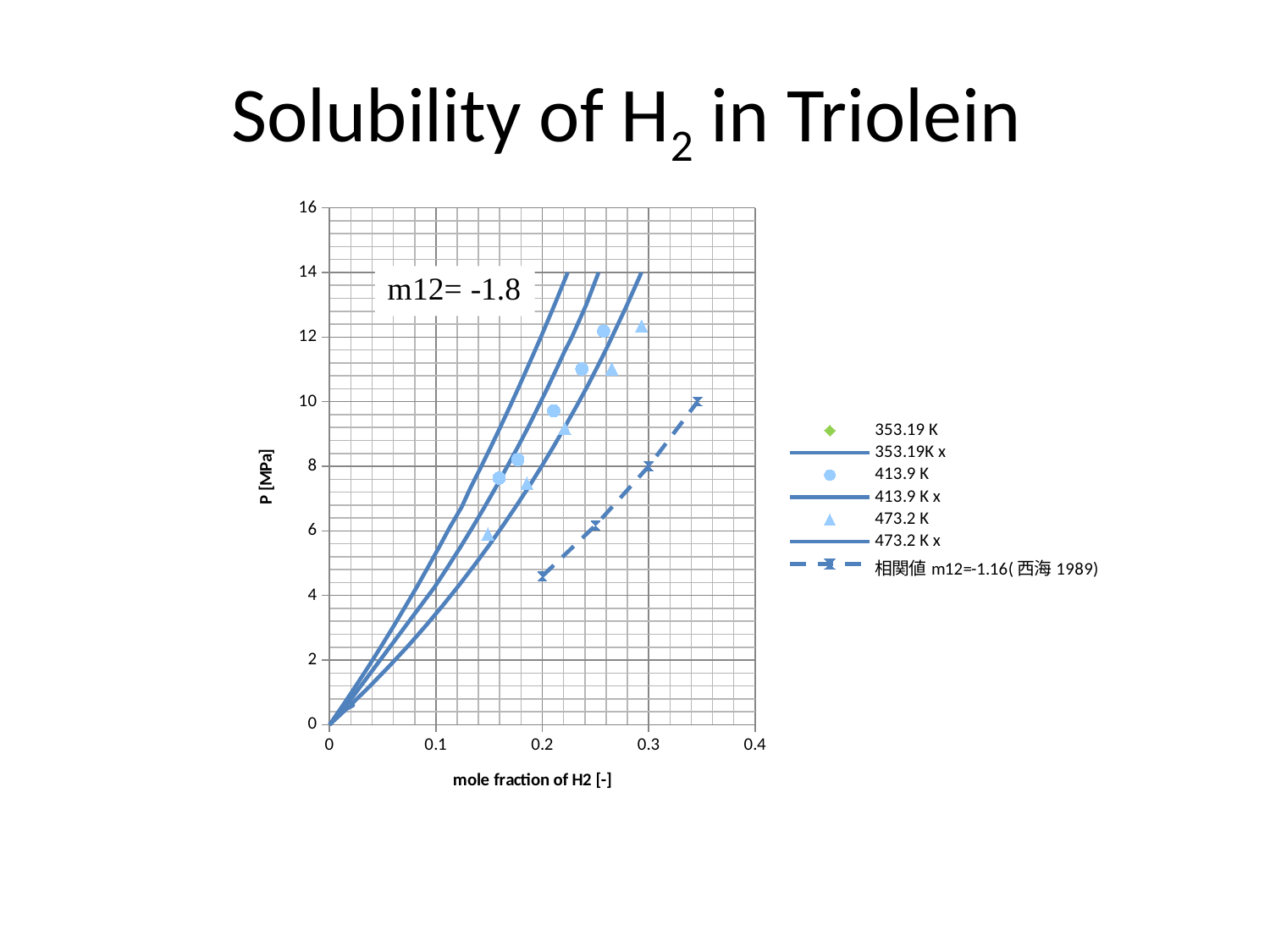
What is the label of the x axis? mole fraction of H2 [-] Is the pressure of the highest point on the dashed correlation line (相関値 m12=-1.16) greater or less than 8 MPa? greater Is the pressure of the highest 413.9 K data point greater or less than 10 MPa? greater At a mole fraction of about 0.3, which is higher: the 473.2 K data point or the dashed correlation line? 473.2 K data point What is the label of the y axis? P [MPa] What is the maximum value shown on the y axis? 16 Do the pressure values rise or fall as the mole fraction of H2 increases? rise How many 413.9 K data points are plotted? 5 What kind of chart is shown on the slide? scatter chart with fitted lines How many series does the legend list? 7 Is the pressure of the lowest point on the dashed correlation line (相関値 m12=-1.16) greater or less than 6 MPa? less